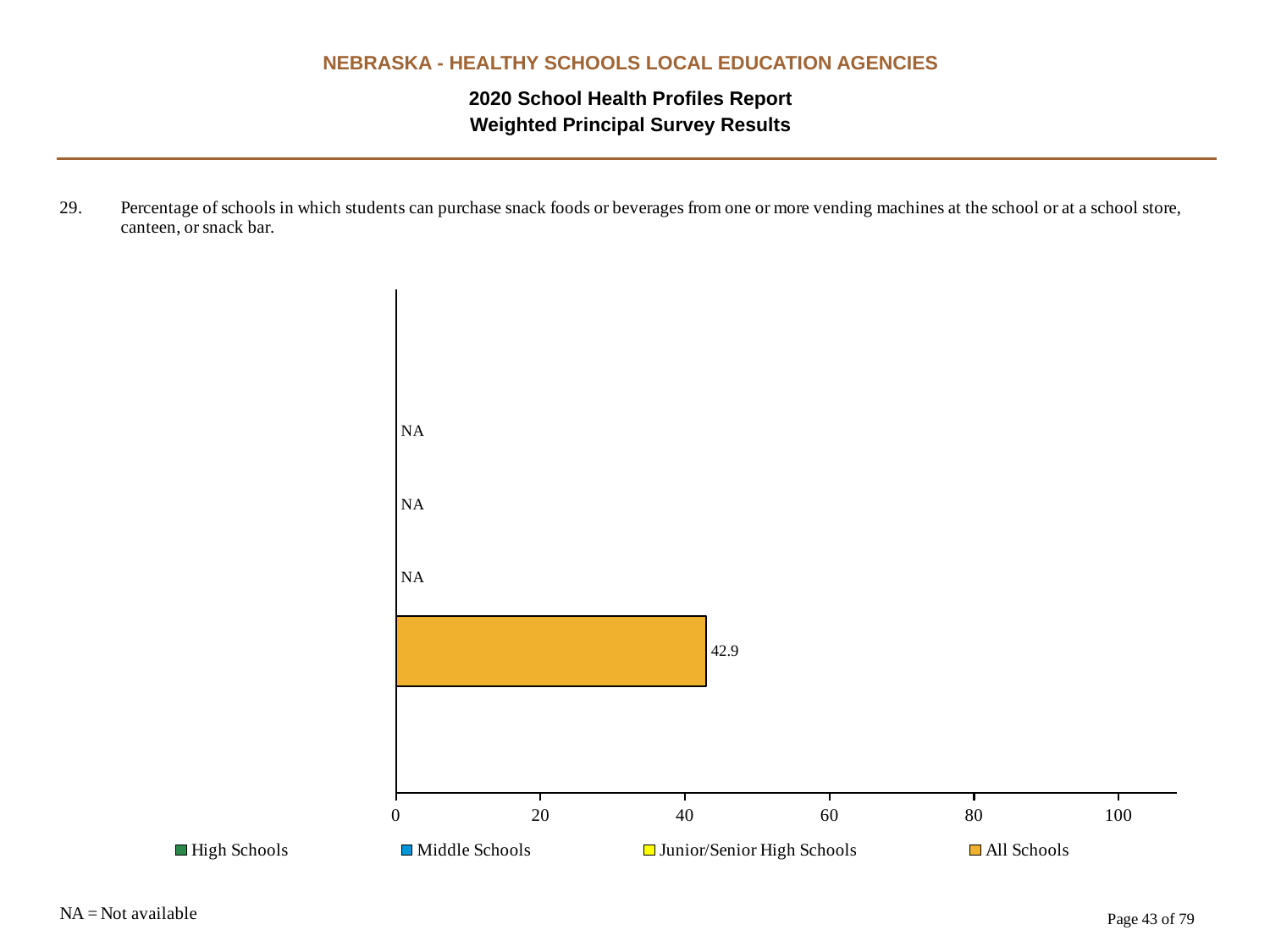
Is the value for All Schools greater or less than 40? greater How many series does the legend list? 4 Is the value for All Schools greater or less than 60? less What is the value for All Schools? 42.9 What is shown for High Schools? NA Which series is the only one with a plotted value rather than NA? All Schools What is shown for Middle Schools? NA How many series are marked NA? 3 What is the highest value shown on the x axis? 100 What is shown for Junior/Senior High Schools? NA What kind of chart is shown on the slide? bar chart